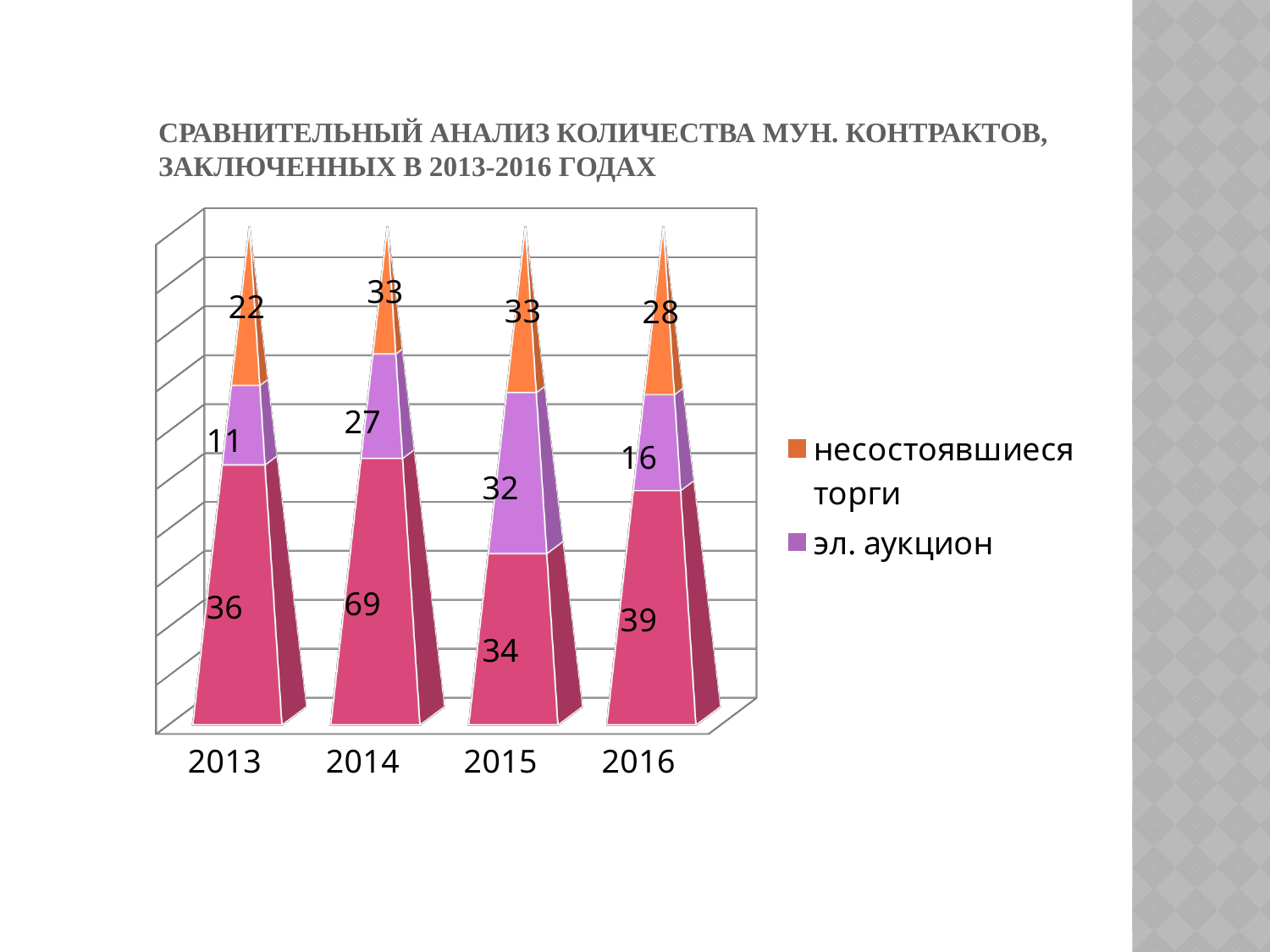
What is the value for эл. аукцион in 2014? 27 What is the total of the stacked bar for 2015? 99 How many series does the legend list? 2 Which year has the lowest value for несостоявшиеся торги? 2013 What kind of chart is shown on the slide? Stacked bar chart What is the value for несостоявшиеся торги in 2016? 28 What is the total of the stacked bar for 2013? 69 What is the difference between the эл. аукцион values for 2014 and 2013? 16 What is the value for эл. аукцион in 2015? 32 Which year has the larger value for несостоявшиеся торги, 2014 or 2016? 2014 How many years are shown on the x axis? 4 Which year has the highest value for эл. аукцион? 2015